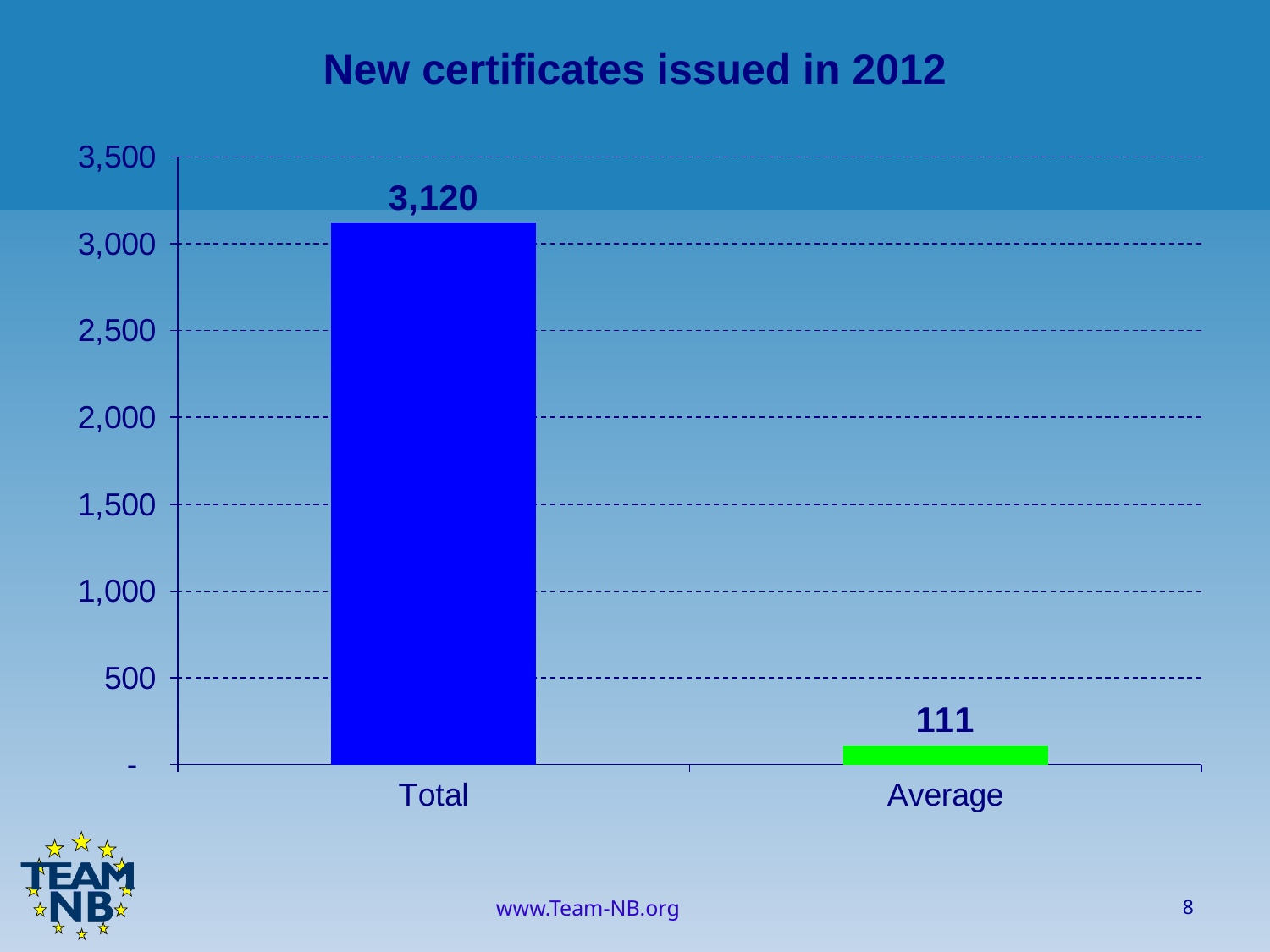
Is the value for Total greater or less than 3,000? greater What is the title of the chart? New certificates issued in 2012 What is the difference between the Total and Average values? 3,009 Is the value for Average greater or less than 500? less What colour is the bar for Average? green Which category has the lowest value? Average How many categories are shown on the chart? 2 What is the value for Total? 3,120 What is the value for Average? 111 What kind of chart is shown on the slide? bar chart Which is larger, the value for Total or the value for Average? Total Which category has the highest value? Total